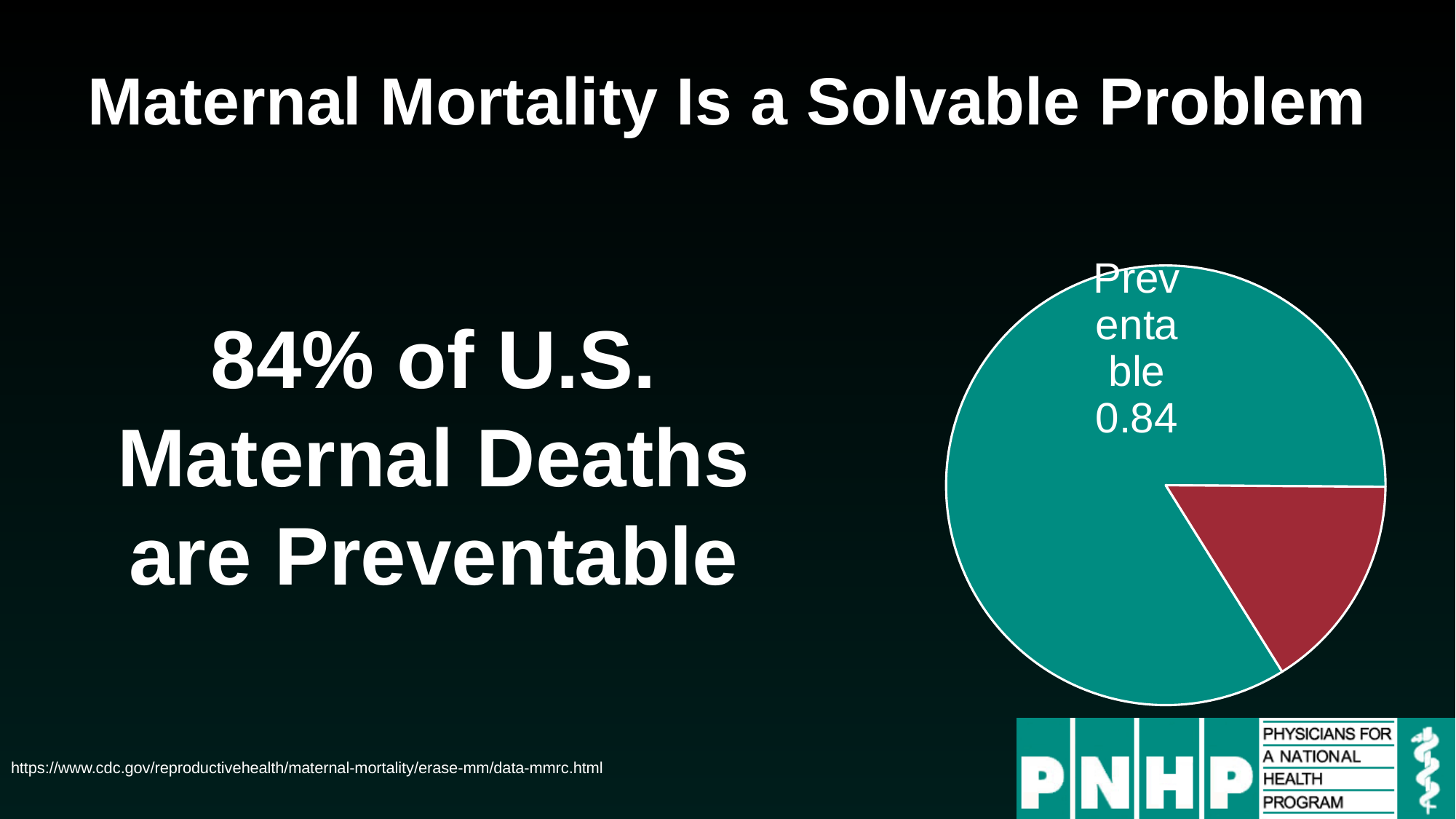
Which slice of the pie chart is the largest? Preventable What value is printed on the Preventable slice of the pie chart? 0.84 How many slices does the pie chart have? 2 What colour is the Preventable slice of the pie chart? teal Is the Preventable slice larger or smaller than the red slice? larger What kind of chart is shown on the slide? pie chart How many slices of the pie chart have a printed label? 1 What share of the pie does the Preventable slice represent, as printed on the chart? 0.84